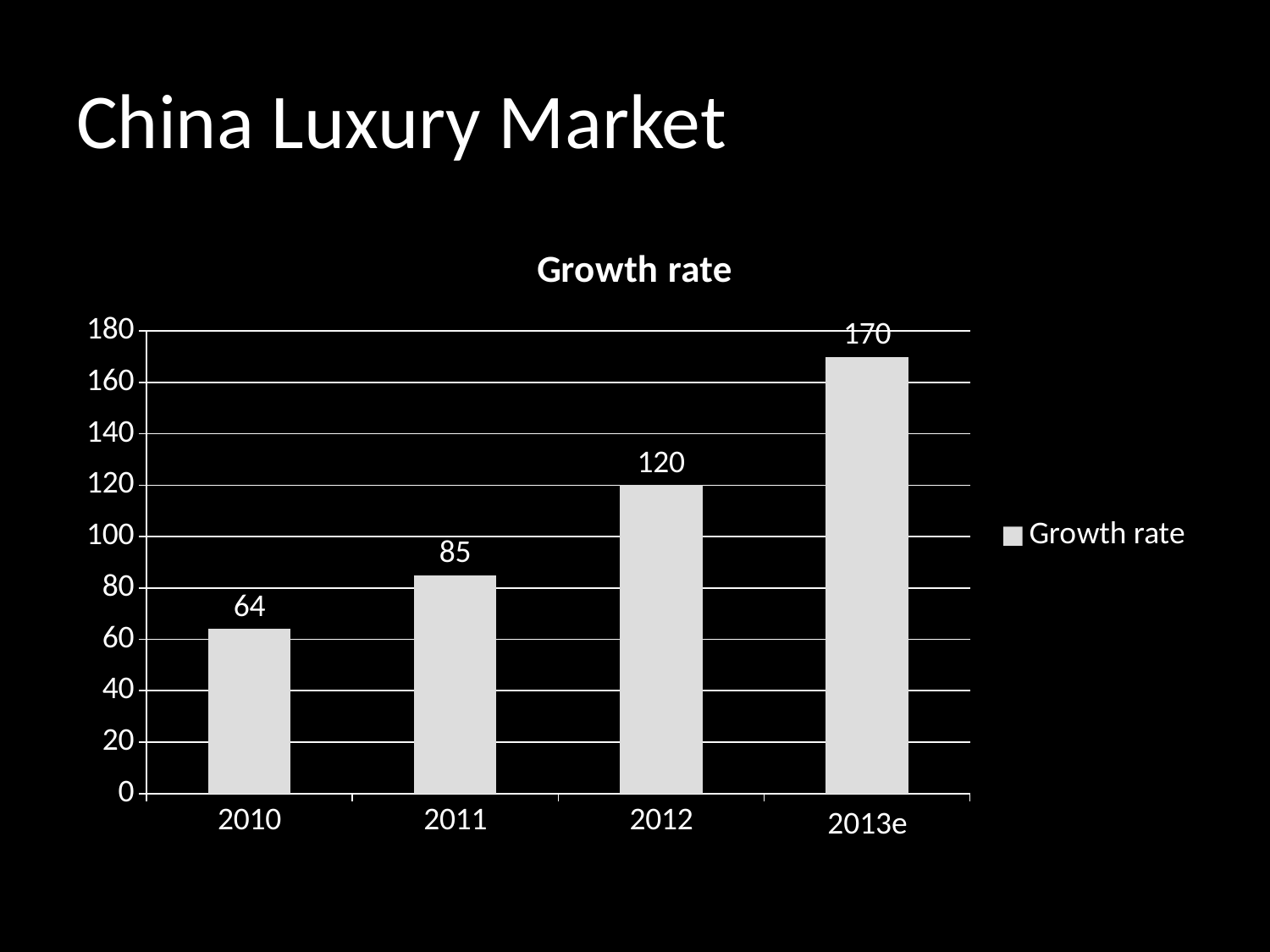
What is the growth rate value for 2013e? 170 What is the difference between the growth rate for 2011 and 2010? 21 What is the growth rate value for 2010? 64 How many years are shown on the x axis? 4 Which year has the highest growth rate? 2013e What is the growth rate value for 2011? 85 What kind of chart is shown on the slide? Bar chart Which is larger, the growth rate for 2011 or for 2012? 2012 Do the growth rate values rise or fall from 2010 to 2013e? Rise What is the difference between the growth rate for 2013e and 2012? 50 What is the growth rate value for 2012? 120 Which year has the lowest growth rate? 2010